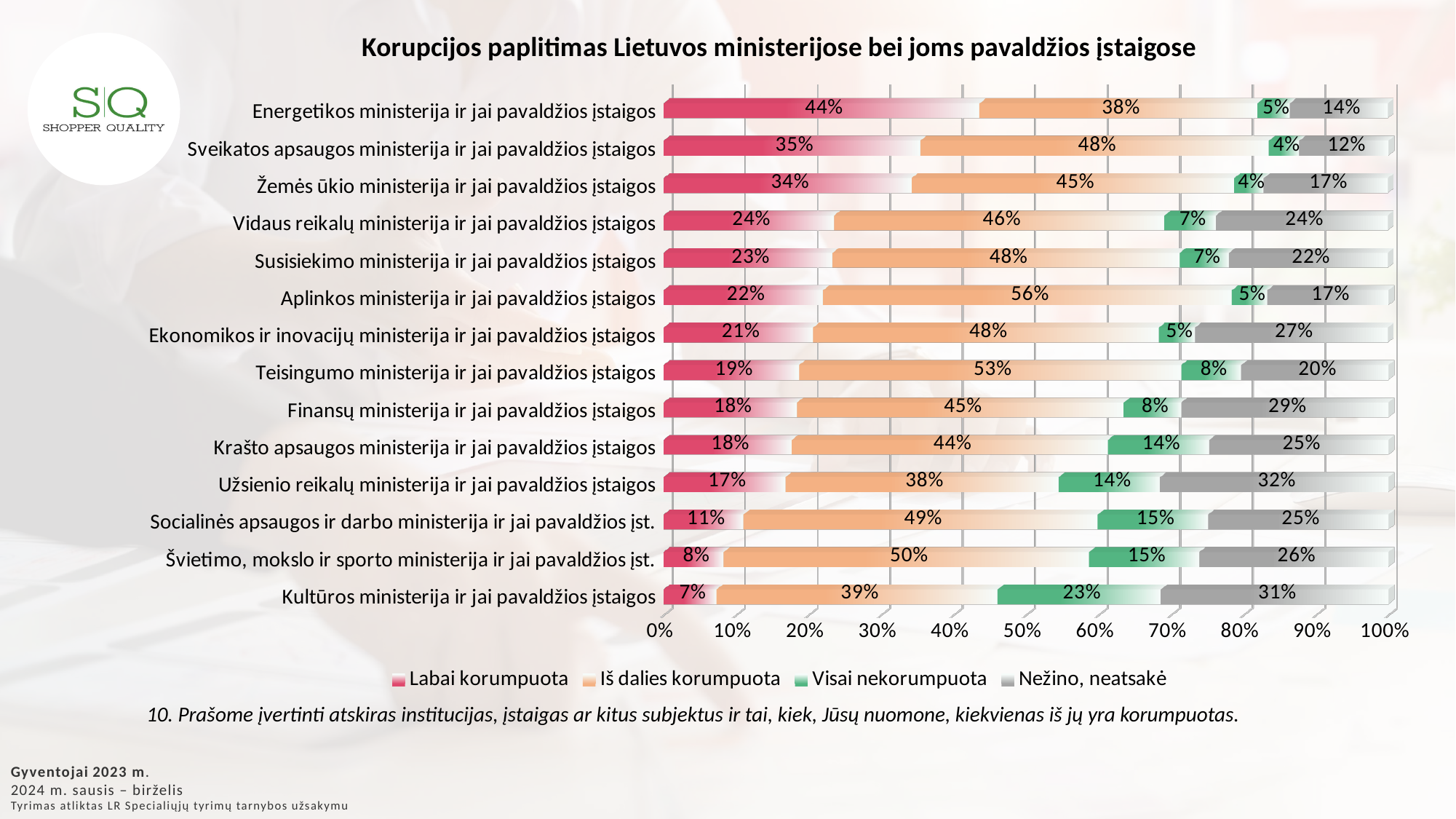
Which ministry has the lowest 'Labai korumpuota' value? Kultūros ministerija ir jai pavaldžios įstaigos What is the difference between the 'Labai korumpuota' values for Energetikos ministerija and Sveikatos apsaugos ministerija? 9% What is the 'Labai korumpuota' value for Energetikos ministerija ir jai pavaldžios įstaigos? 44% What is the 'Iš dalies korumpuota' value for Aplinkos ministerija ir jai pavaldžios įstaigos? 56% What kind of chart is shown on the slide? stacked bar chart Which is larger: the 'Iš dalies korumpuota' value for Teisingumo ministerija or for Finansų ministerija? Teisingumo ministerija What is the 'Nežino, neatsakė' value for Užsienio reikalų ministerija ir jai pavaldžios įstaigos? 32% How many series does the legend list? 4 How many ministries (categories) are plotted in the chart? 14 Do the 'Labai korumpuota' values rise or fall going down the list of ministries from top to bottom? fall Which ministry has the highest 'Visai nekorumpuota' value? Kultūros ministerija ir jai pavaldžios įstaigos Which legend entry is shown in green? Visai nekorumpuota